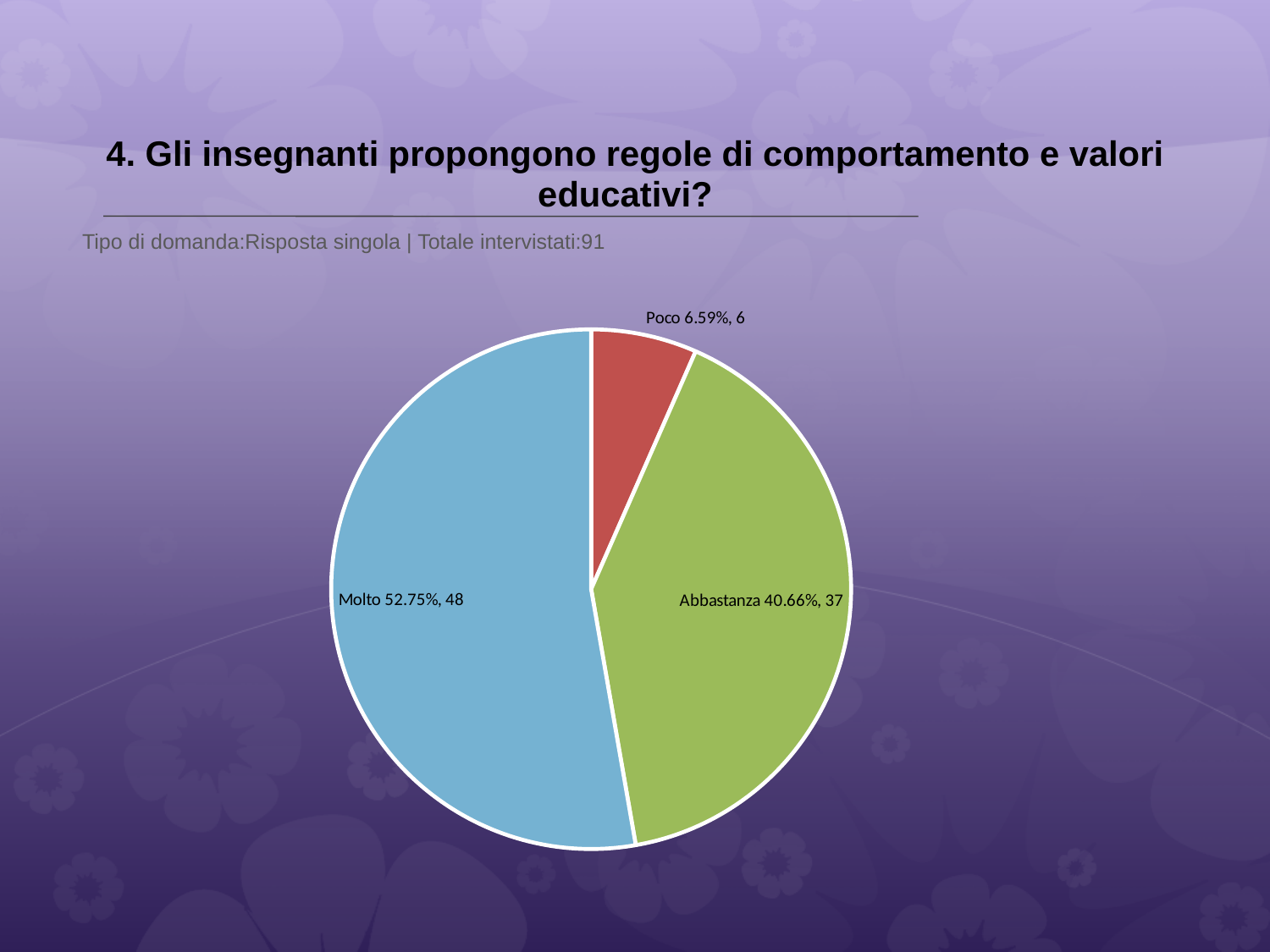
How many slices does the pie chart have? 3 What percentage share does the Poco slice have? 6.59% What kind of chart is shown on the slide? pie chart What percentage share does the Abbastanza slice have? 40.66% How many respondents answered Abbastanza? 37 What is the difference in respondent count between Molto and Abbastanza? 11 How many respondents answered Molto? 48 Which category has the smallest slice? Poco Which is larger, the Abbastanza slice or the Poco slice? Abbastanza What percentage share does the Molto slice have? 52.75% Which category has the largest slice? Molto How many respondents answered Poco? 6